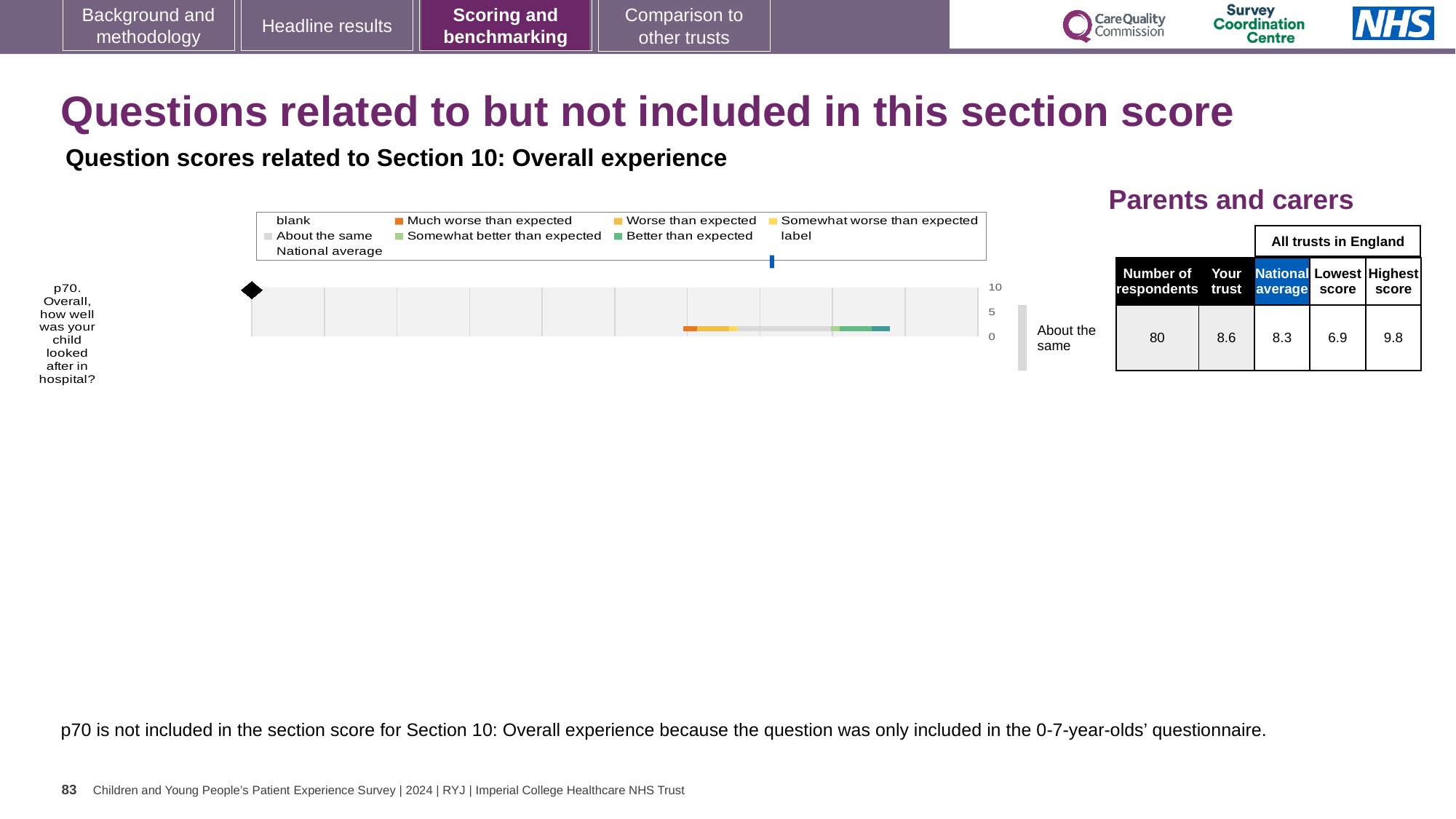
Which is larger for p70: the 'Your trust' score or the national average? Your trust What is the maximum value shown on the chart's score axis? 10 What is the difference between the highest score and the lowest score for p70? 2.9 How many questions are plotted in the chart? 1 What is the 'Your trust' score for p70 (Overall, how well was your child looked after in hospital?)? 8.6 What is the highest score among all trusts in England for p70? 9.8 What is the lowest score among all trusts in England for p70? 6.9 What kind of chart is used to show the p70 benchmarking result? bar chart What is the national average score for p70? 8.3 Which benchmarking category is the trust's p70 result placed in? About the same How many respondents answered p70 for this trust? 80 By how much does the 'Your trust' score for p70 exceed the national average? 0.3